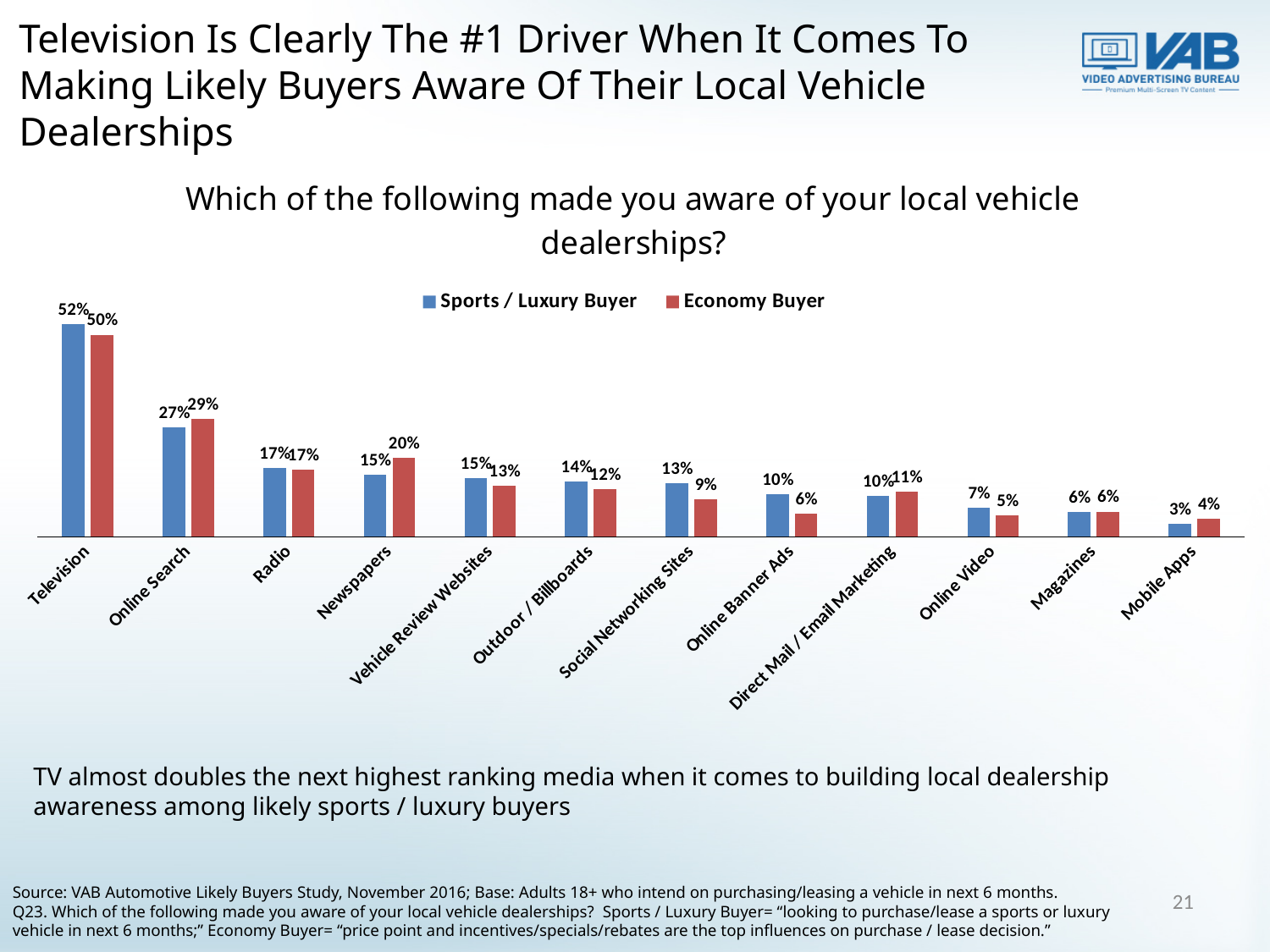
For Online Banner Ads, which is larger: the Sports / Luxury Buyer value or the Economy Buyer value? Sports / Luxury Buyer Which category has the lowest value for Sports / Luxury Buyers? Mobile Apps What is the difference between the Sports / Luxury Buyer and Economy Buyer values for Television? 2% How many series does the legend list? 2 Which category has the highest value for Economy Buyers? Television What percentage of Sports / Luxury Buyers said Television made them aware of their local vehicle dealerships? 52% What is the Economy Buyer value for Online Search? 29% Which colour represents Economy Buyer in the chart? Red What is the difference between the Sports / Luxury Buyer and Economy Buyer values for Social Networking Sites? 4% How many categories are shown on the x axis of the chart? 12 What kind of chart is shown on the slide? Bar chart What is the Economy Buyer value for Newspapers? 20%